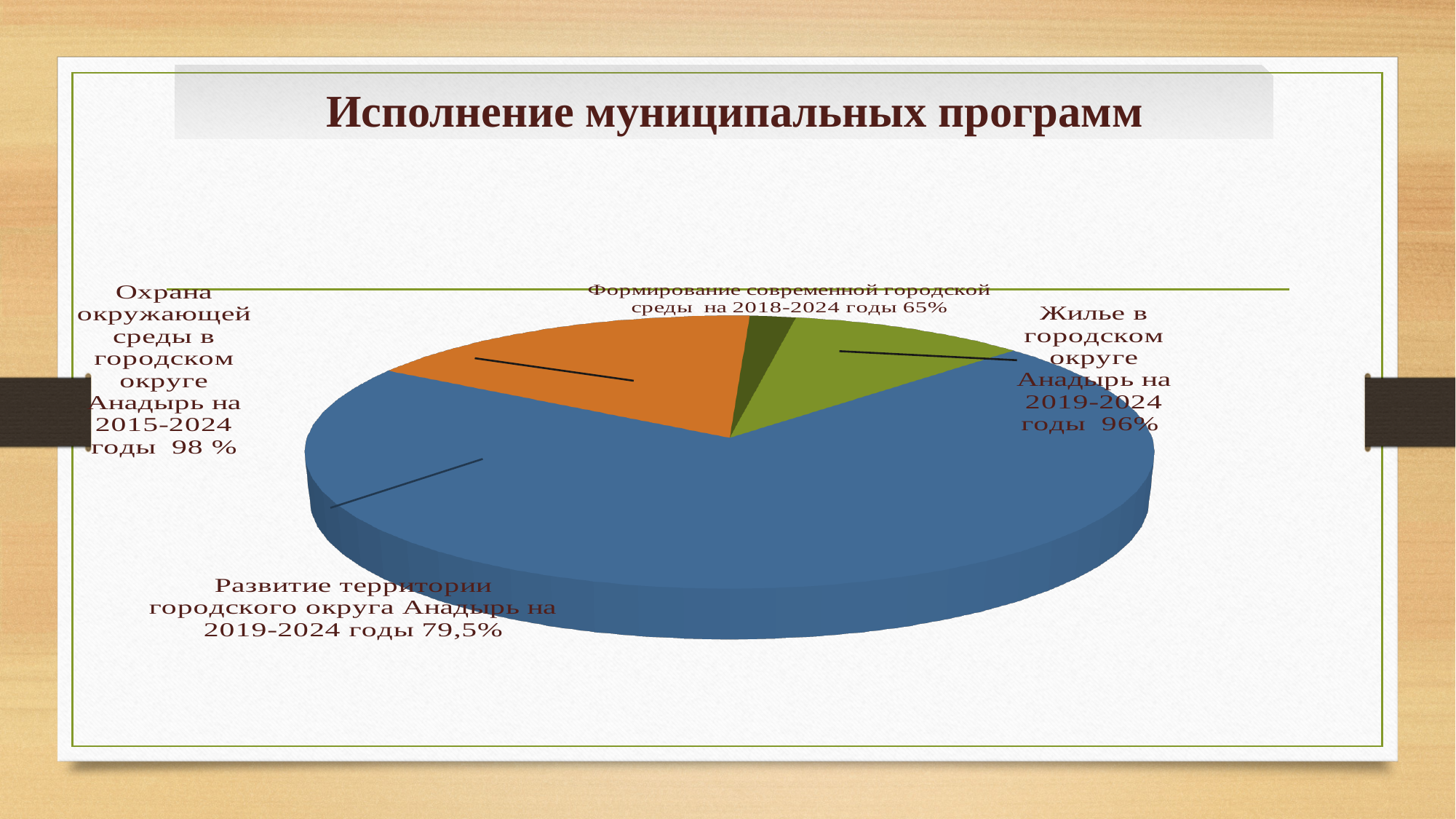
What is the difference between the values for «Охрана окружающей среды» (98 %) and «Формирование современной городской среды» (65%)? 33 Which has the larger printed value: «Жилье в городском округе Анадырь» or «Развитие территории городского округа Анадырь»? Жилье в городском округе Анадырь What is the title of the chart on the slide? Исполнение муниципальных программ Which programme has the lowest printed value? Формирование современной городской среды на 2018-2024 годы What value is shown for «Жилье в городском округе Анадырь на 2019-2024 годы»? 96% What colour is the largest slice of the pie chart? blue What value is shown for «Охрана окружающей среды в городском округе Анадырь на 2015-2024 годы»? 98 % How many slices does the pie chart have? 4 What kind of chart is shown on the slide? pie chart What value is shown for «Развитие территории городского округа Анадырь на 2019-2024 годы»? 79,5% Which programme has the highest printed value? Охрана окружающей среды в городском округе Анадырь на 2015-2024 годы What value is shown for «Формирование современной городской среды на 2018-2024 годы»? 65%